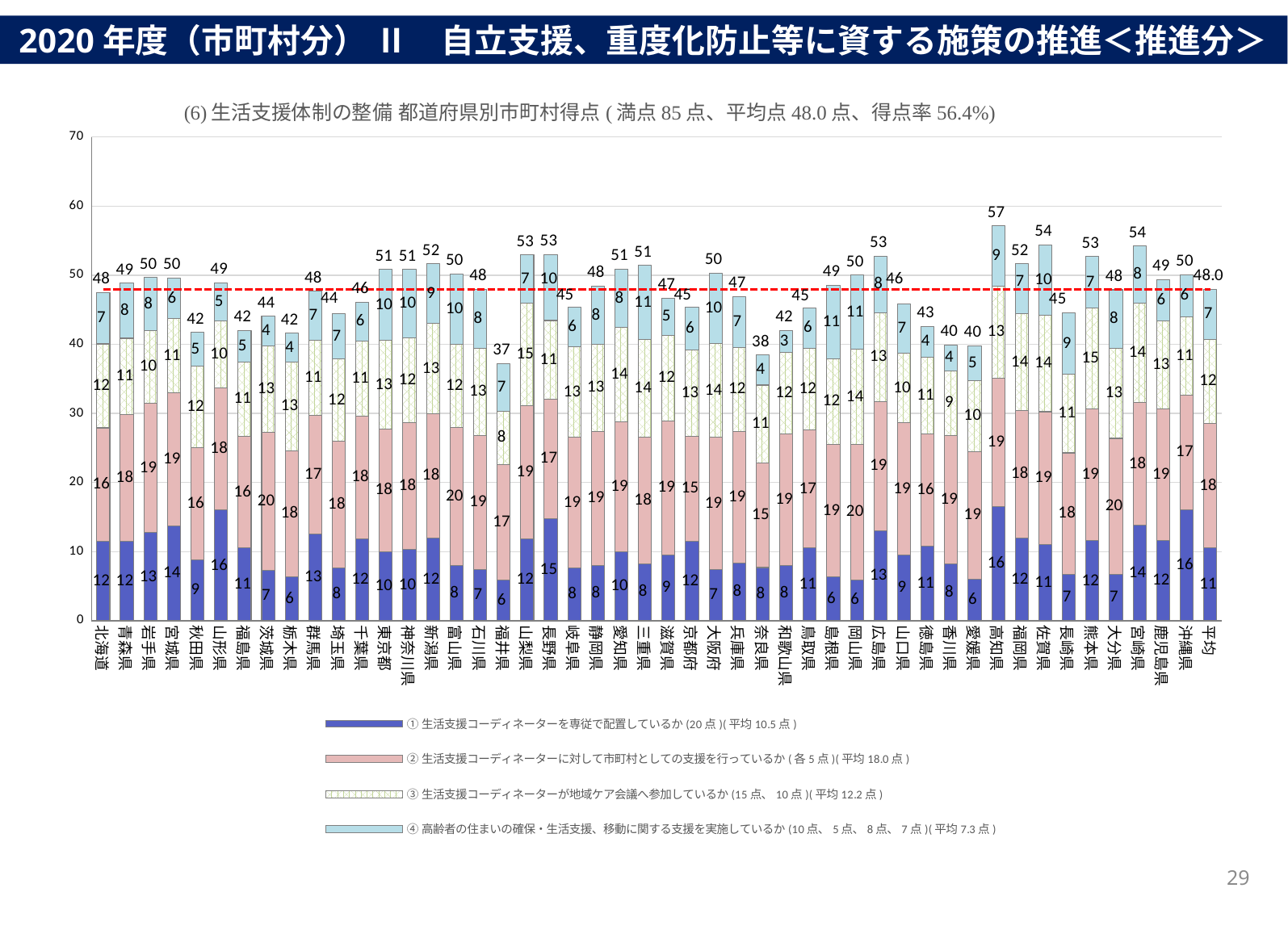
What is the total score shown for 福井県? 37 What is the total score shown for 高知県? 57 What kind of chart is shown on the slide? Stacked bar chart Which category has the highest total score in the chart? 高知県 What is the total score shown for 東京都? 51 What value does the red dashed horizontal line mark on the chart? 48.0 What is the value of the bottom (dark blue) segment for 高知県? 16 What is the total score shown for 平均 (the rightmost bar)? 48.0 How many series does the legend list? 4 What is the difference between the total scores of 高知県 and 福井県? 20 Which has a higher total score, 新潟県 or 奈良県? 新潟県 Which category has the lowest total score in the chart? 福井県